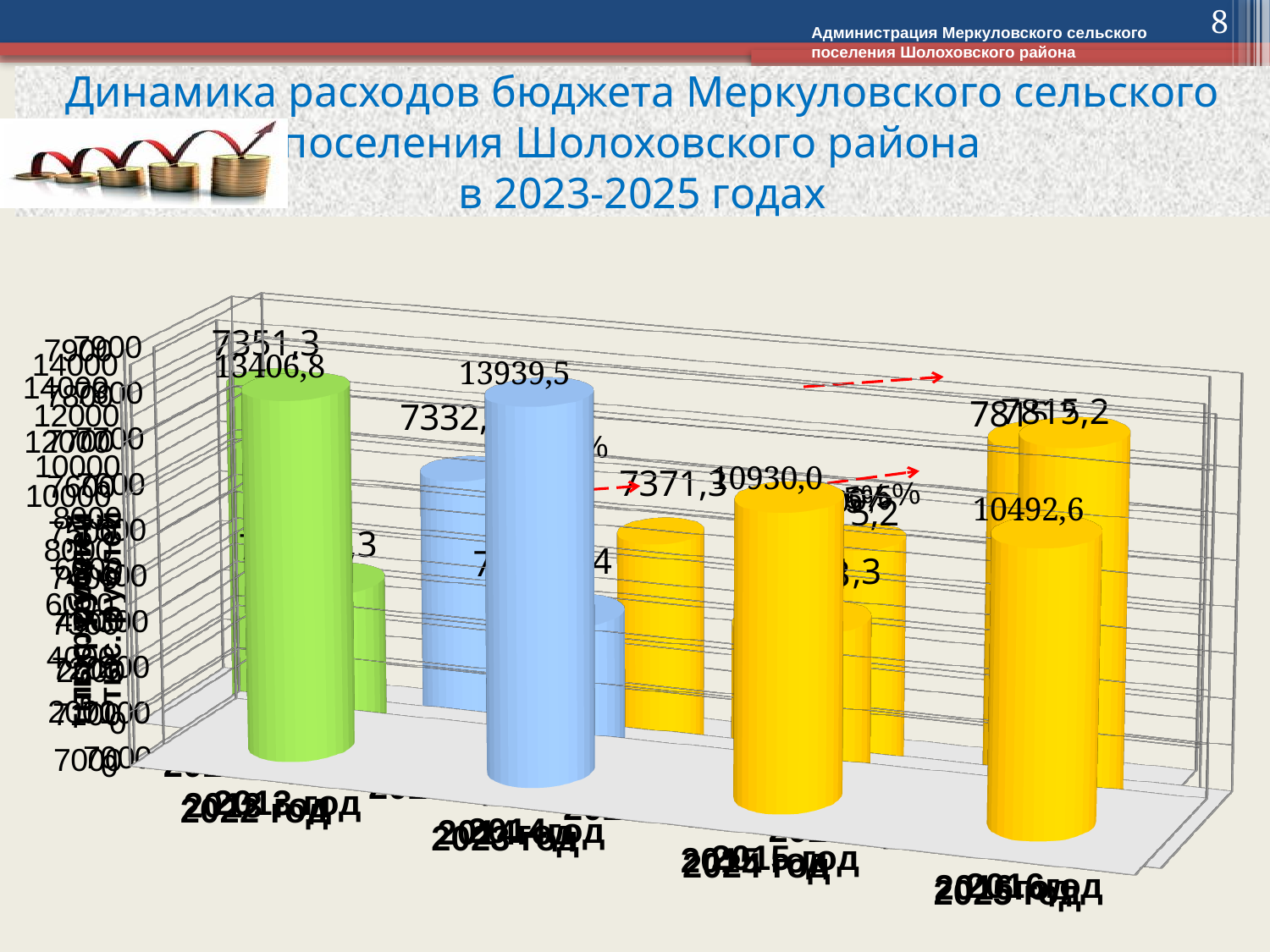
What kind of chart is shown on the slide? bar chart Which is larger, the value printed on the tall blue cylinder (13939,5) or the tall green cylinder (13406,8)? 13939,5 What value is printed above the tall blue cylinder in the front row? 13939,5 What value is printed above the tall green cylinder in the front row? 13406,8 What is the title of the slide's chart? Динамика расходов бюджета Меркуловского сельского поселения Шолоховского района в 2023-2025 годах What is the difference between the values printed on the tall blue cylinder (13939,5) and the tall green cylinder (13406,8)? 532,7